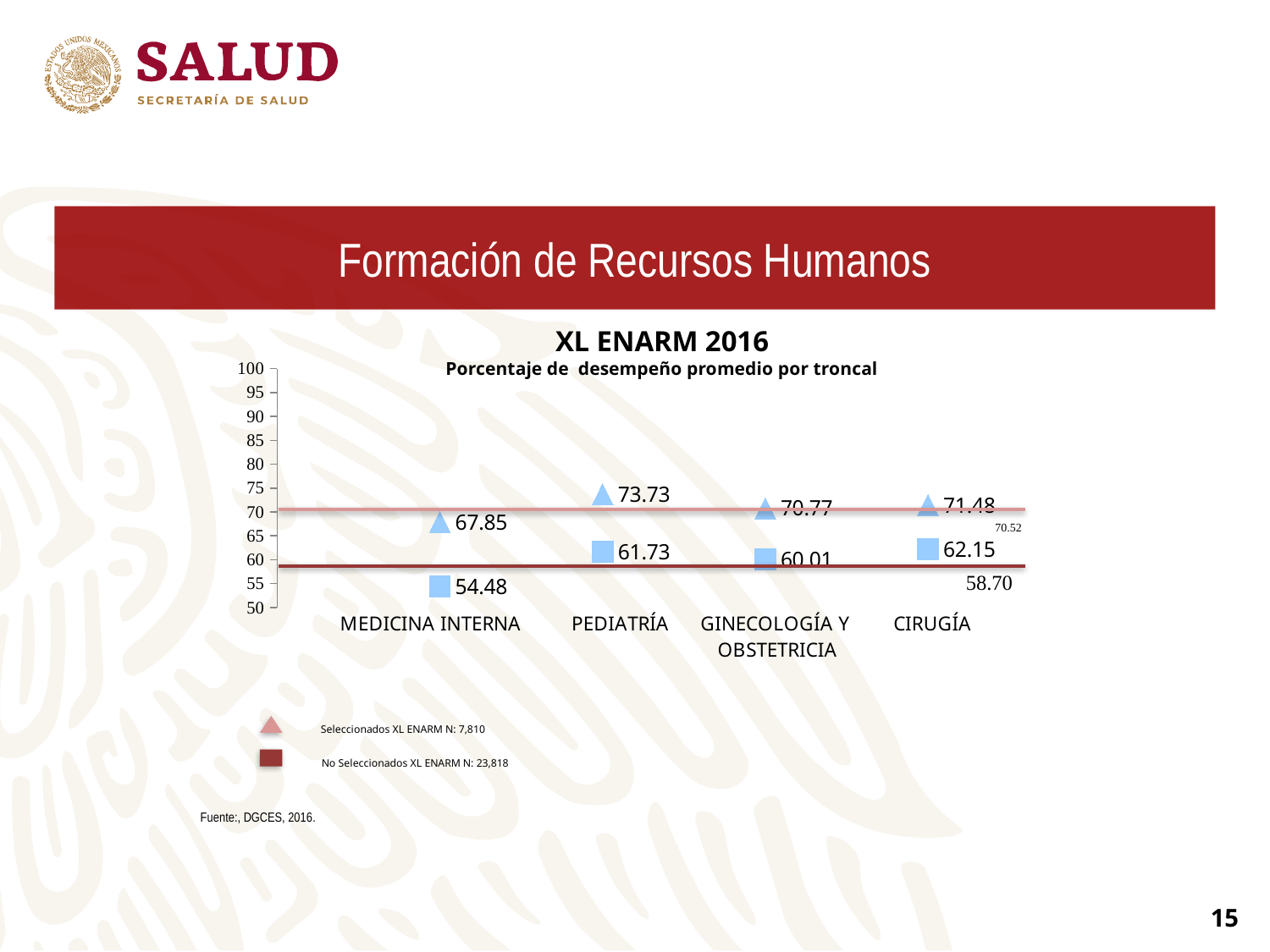
What is the value for Seleccionados in Medicina Interna? 67.85 What is the value for No Seleccionados in Medicina Interna? 54.48 What is the value for No Seleccionados in Cirugía? 62.15 Which category has the lowest value for No Seleccionados? Medicina Interna How many categories are shown on the x axis? 4 Which category has the highest value for Seleccionados? Pediatría Which is larger: the Seleccionados value for Cirugía or for Medicina Interna? Cirugía What is the difference between the Seleccionados and No Seleccionados values in Pediatría? 12.00 What is the value for Seleccionados in Pediatría? 73.73 How many series does the legend list? 2 What is the subtitle of the chart below 'XL ENARM 2016'? Porcentaje de desempeño promedio por troncal Is the No Seleccionados value for Medicina Interna greater or less than 60? less